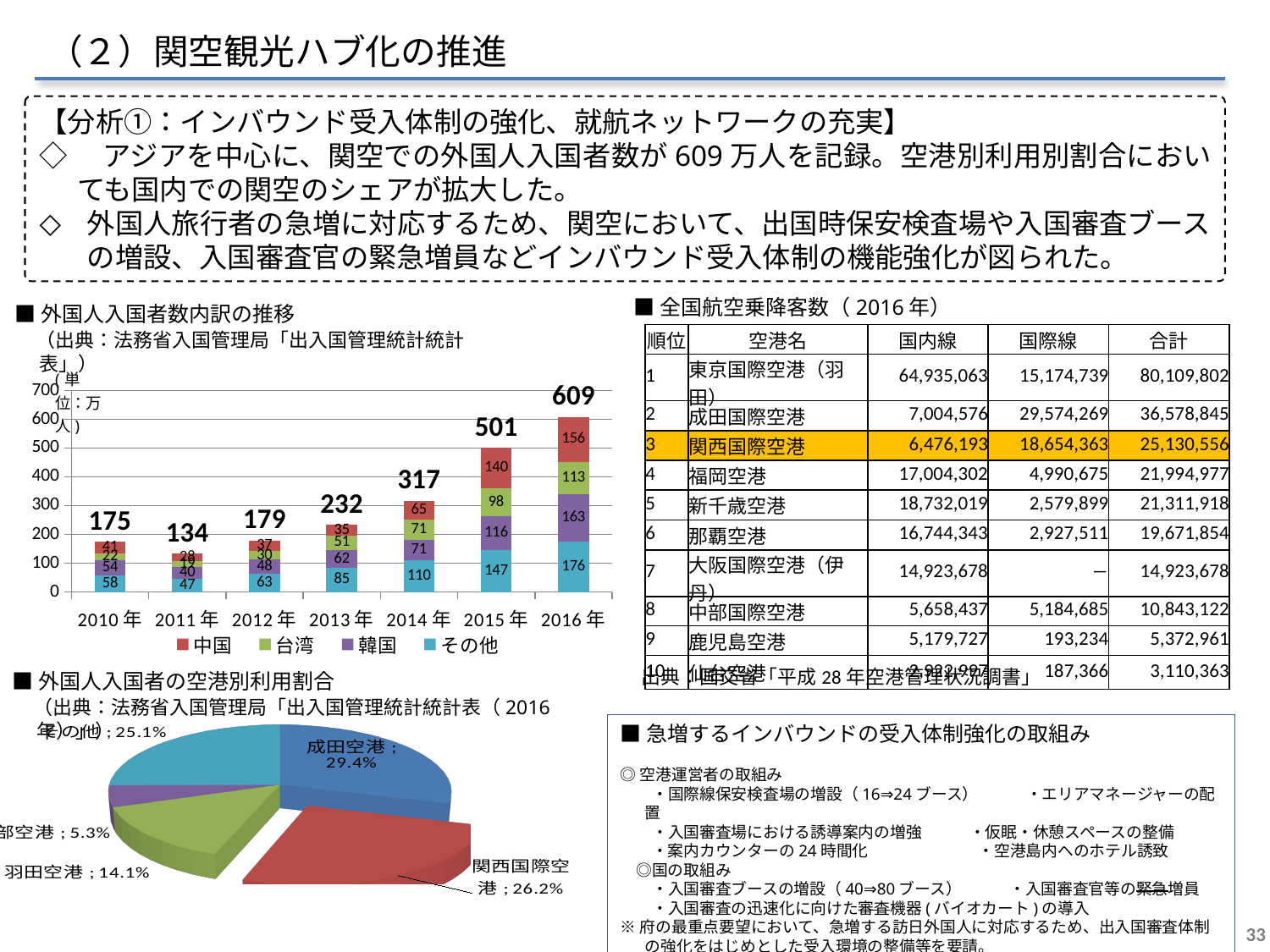
In the stacked bar chart 外国人入国者数内訳の推移, what is the difference between the totals for 2016年 and 2015年? 108 In the stacked bar chart 外国人入国者数内訳の推移, how many years are shown on the x axis? 7 In the stacked bar chart 外国人入国者数内訳の推移, how many series does the legend list? 4 In the stacked bar chart 外国人入国者数内訳の推移, what is the value for 中国 in 2016年? 156 In the stacked bar chart 外国人入国者数内訳の推移, which year has the lowest total? 2011年 In the stacked bar chart 外国人入国者数内訳の推移, do the totals rise or fall from 2013年 to 2016年? rise In the stacked bar chart 外国人入国者数内訳の推移, what is the value for その他 in 2015年? 147 In the stacked bar chart 外国人入国者数内訳の推移, which is larger in 2014年, 中国 or その他? その他 In the pie chart 外国人入国者の空港別利用割合, which airport has the largest share? 成田空港 In the pie chart 外国人入国者の空港別利用割合, what share does 関西国際空港 have? 26.2% What kind of chart is 外国人入国者の空港別利用割合? pie chart In the stacked bar chart 外国人入国者数内訳の推移, what is the total for 2016年? 609